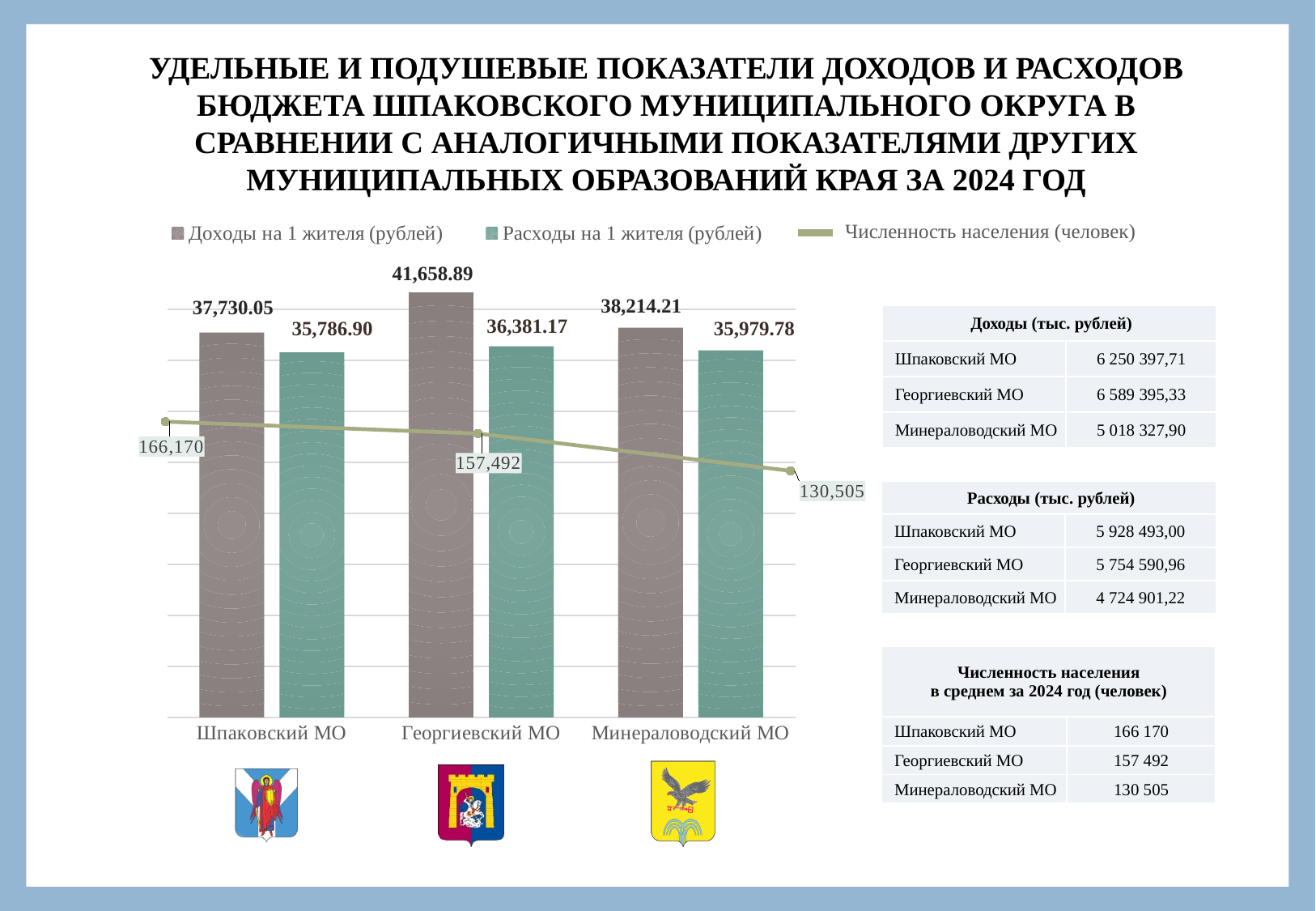
Which municipality has the lowest Расходы на 1 жителя (рублей)? Шпаковский МО Which municipality has the highest Доходы на 1 жителя (рублей)? Георгиевский МО What is the value of Доходы на 1 жителя (рублей) for Георгиевский МО? 41,658.89 Which is larger: Доходы на 1 жителя for Минераловодский МО or for Шпаковский МО? Минераловодский МО Does the Численность населения line rise or fall from Шпаковский МО to Минераловодский МО? Falls What is the value of Расходы на 1 жителя (рублей) for Шпаковский МО? 35,786.90 What kind of chart is shown on the slide? Combined bar and line chart How many municipalities are shown on the x axis of the chart? 3 What is the difference in Численность населения between Шпаковский МО and Минераловодский МО? 35,665 What is the Численность населения (человек) value shown for Минераловодский МО? 130,505 How many series does the chart legend list? 3 What is the difference between Доходы на 1 жителя and Расходы на 1 жителя for Георгиевский МО? 5,277.72